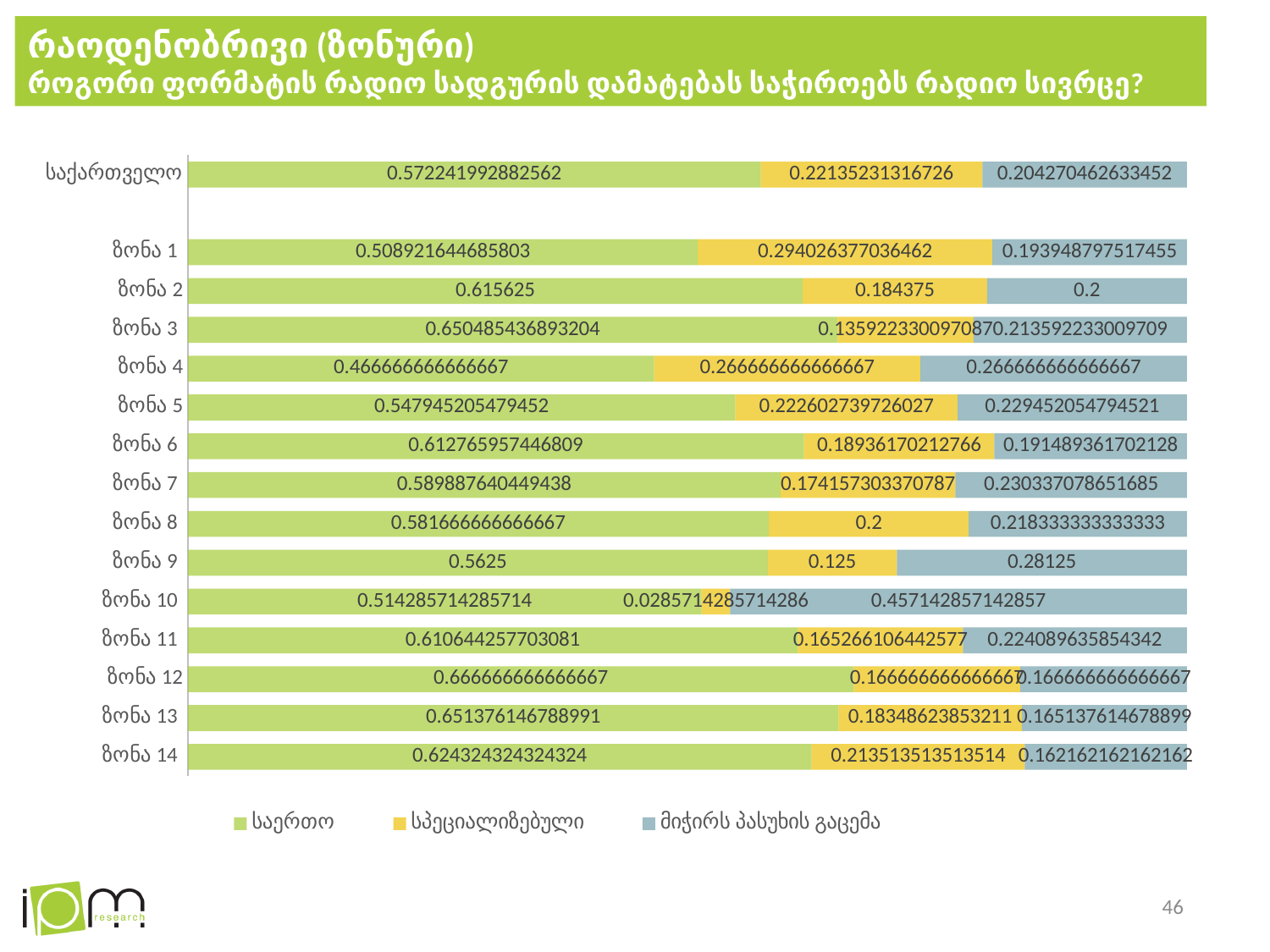
What is the value of სპეციალიზებული for ზონა 10? 0.0285714285714286 What kind of chart is shown on the slide? stacked bar chart Which category has the highest value for მიჭირს პასუხის გაცემა? ზონა 10 What is the value of საერთო for ზონა 2? 0.615625 What is the value of საერთო for საქართველო? 0.572241992882562 What is the value of მიჭირს პასუხის გაცემა for ზონა 9? 0.28125 How many series does the legend list? 3 What is the difference between საერთო and სპეციალიზებული for ზონა 2? 0.43125 How many categories are plotted on the chart? 15 Which category has the highest value for საერთო? ზონა 12 Which category has the lowest value for საერთო? ზონა 4 For ზონა 10, which is larger: სპეციალიზებული or მიჭირს პასუხის გაცემა? მიჭირს პასუხის გაცემა